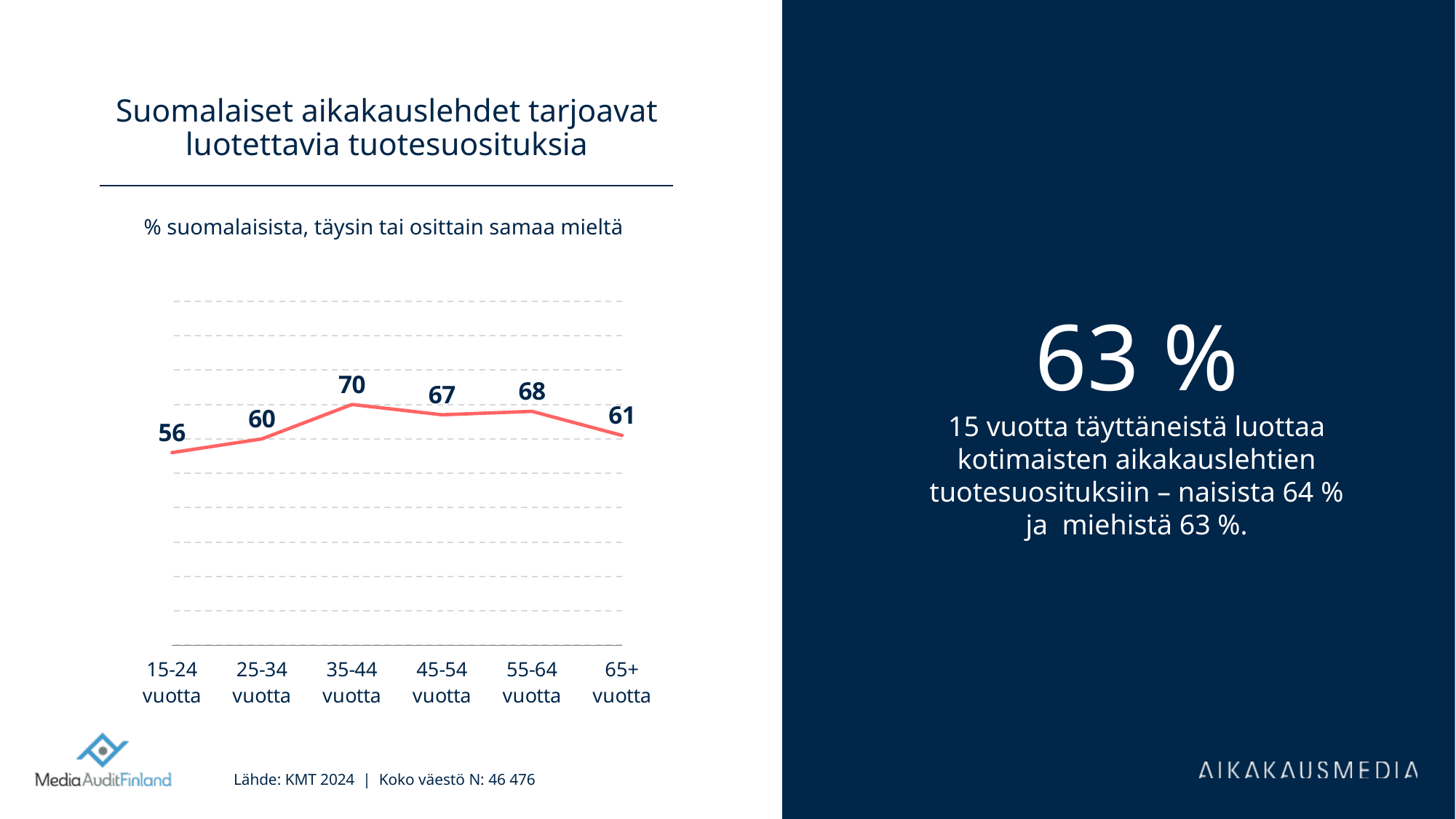
What is the value for the 35-44 vuotta age group? 70 What is the value for the 65+ vuotta age group? 61 What is the difference between the values for 35-44 vuotta and 15-24 vuotta? 14 What is the value for the 15-24 vuotta age group? 56 Do the values rise or fall from 15-24 vuotta to 35-44 vuotta? Rise Which age group has the lowest value? 15-24 vuotta What kind of chart is shown on the slide? Line chart How many age groups are plotted on the chart? 6 What is the value for the 55-64 vuotta age group? 68 Which age group has the highest value? 35-44 vuotta Which is larger, the value for 45-54 vuotta or the value for 65+ vuotta? 45-54 vuotta What is the title of the chart? Suomalaiset aikakauslehdet tarjoavat luotettavia tuotesuosituksia